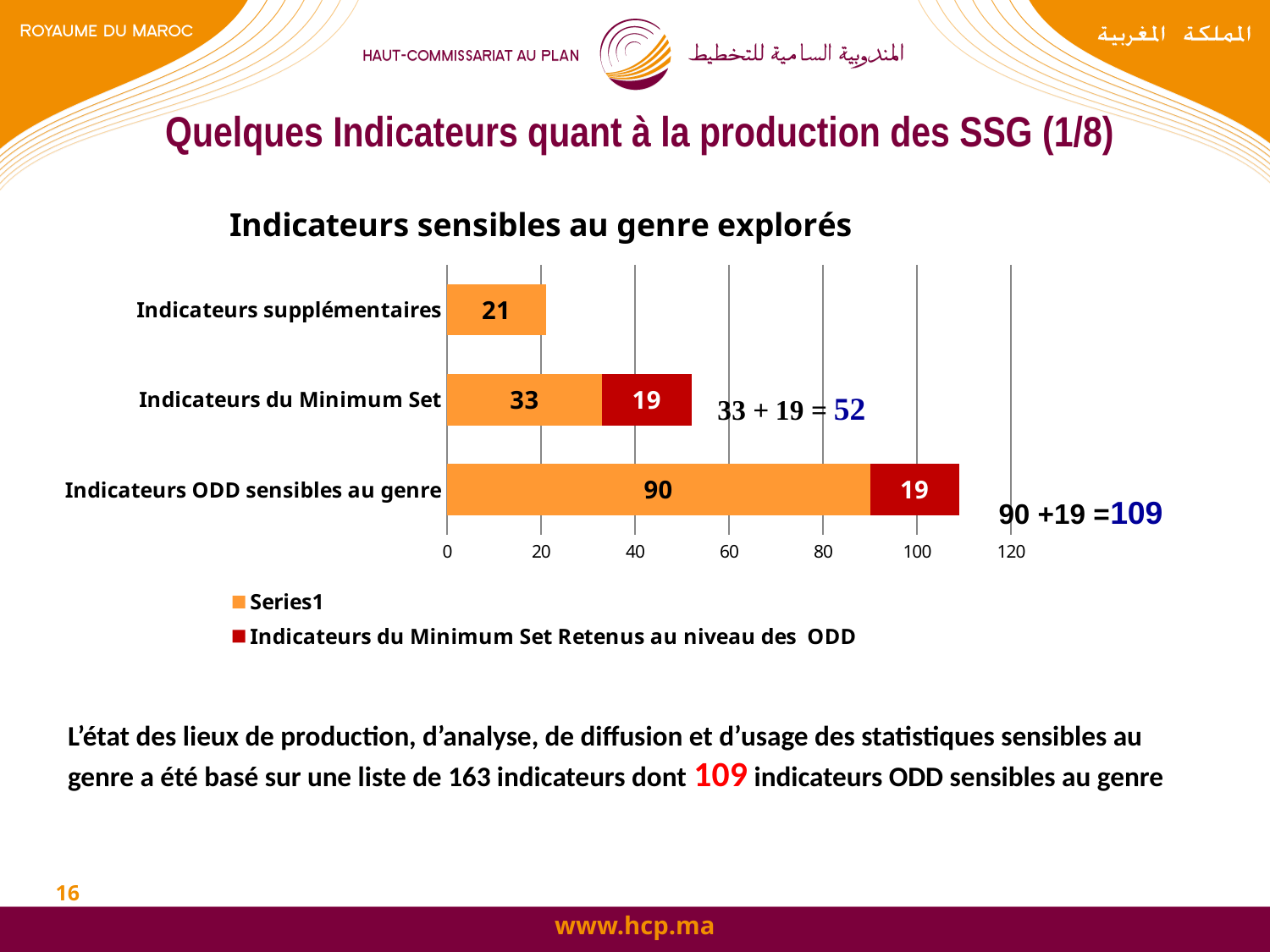
What is the value of 'Indicateurs du Minimum Set Retenus au niveau des ODD' for Indicateurs du Minimum Set? 19 What is the total of the stacked bar for Indicateurs du Minimum Set? 52 Which category has the highest Series1 value? Indicateurs ODD sensibles au genre What is the total of the stacked bar for Indicateurs ODD sensibles au genre? 109 How many series does the legend list? 2 How many categories are shown on the chart? 3 What is the Series1 value for Indicateurs supplémentaires? 21 Which is larger: the Series1 value for Indicateurs du Minimum Set or for Indicateurs supplémentaires? Indicateurs du Minimum Set What is the difference between the Series1 values for Indicateurs ODD sensibles au genre and Indicateurs du Minimum Set? 57 What is the Series1 value for Indicateurs ODD sensibles au genre? 90 What kind of chart is shown on the slide? Stacked bar chart Which category has the lowest Series1 value? Indicateurs supplémentaires